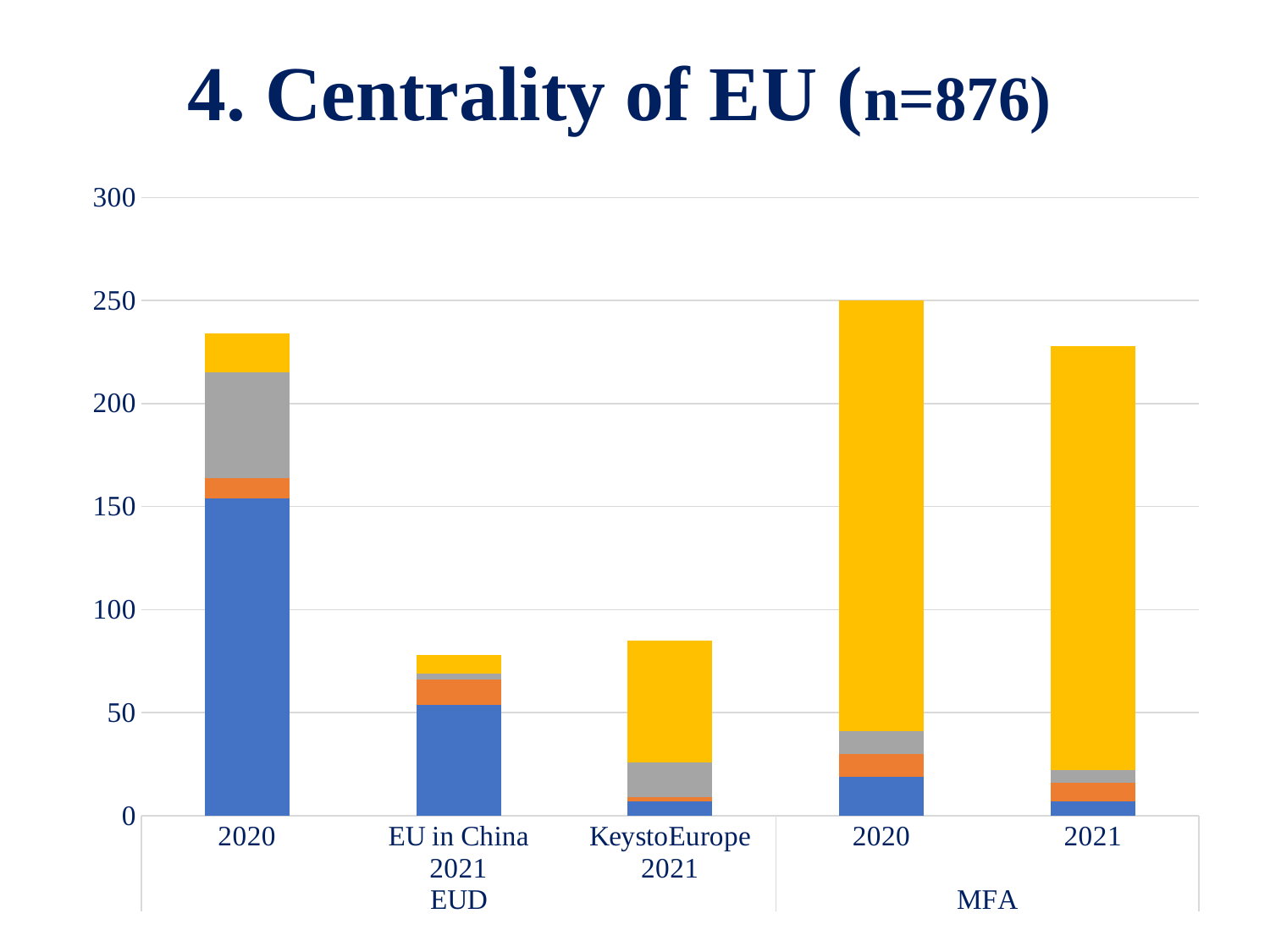
Which bar has the highest total in the chart? 2020 (MFA) Is the total of the EUD 2020 bar greater or less than 200? greater What kind of chart is shown on the slide? stacked bar chart Is the total of the MFA 2021 bar greater or less than 200? greater Is the total of the KeystoEurope 2021 bar greater or less than 50? greater What is the title of the chart on the slide? 4. Centrality of EU (n=876) What are the two group labels shown beneath the x axis? EUD and MFA Which bar has the larger total, KeystoEurope 2021 or EUD 2020? EUD 2020 How many bars are plotted in the chart? 5 Which bar has the larger total, EU in China 2021 or MFA 2021? MFA 2021